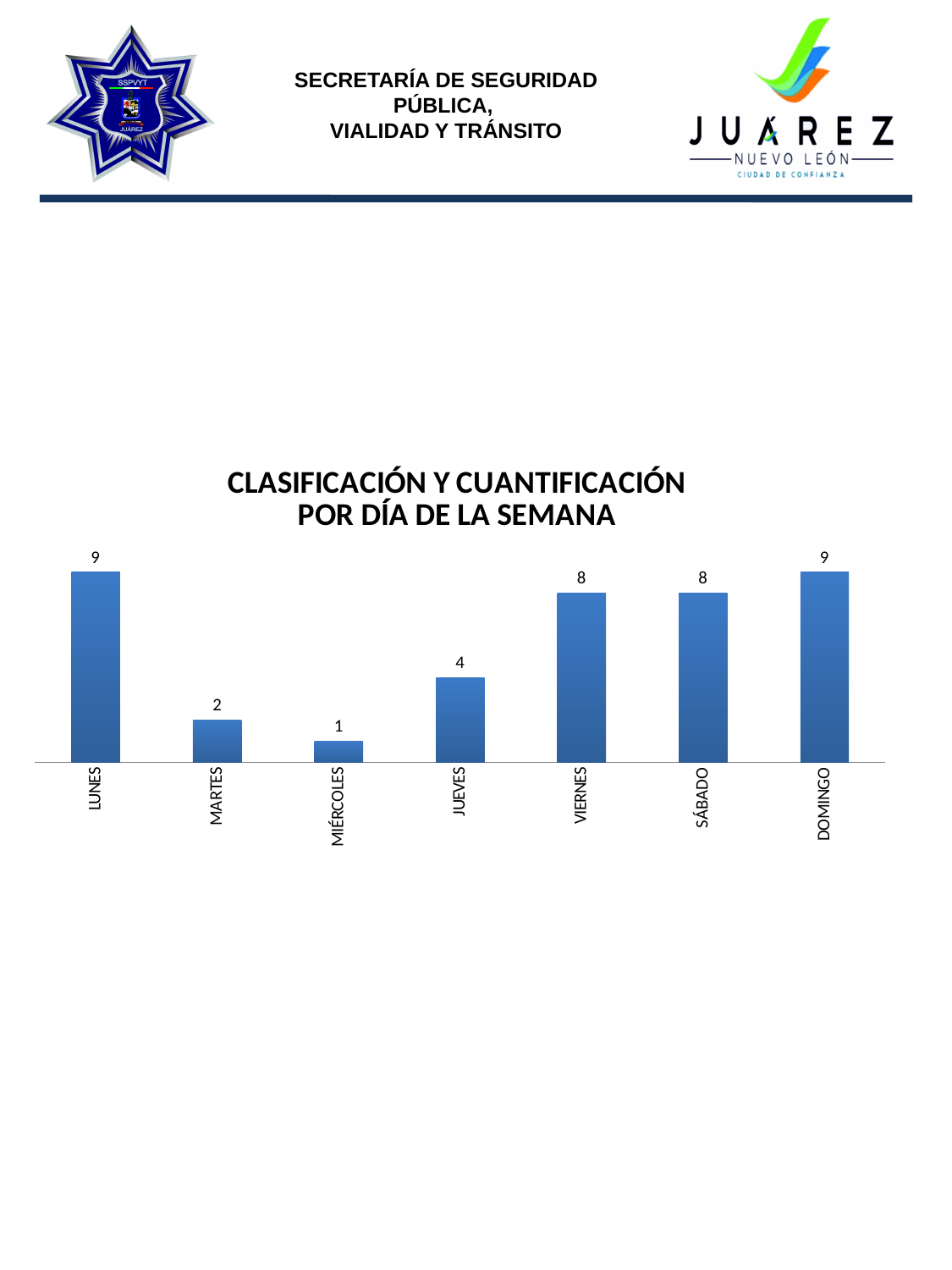
What is the difference between the values for VIERNES and MARTES? 6 Which day has the lowest value? MIÉRCOLES Which is larger, the value for MIÉRCOLES or the value for SÁBADO? SÁBADO What is the title of the chart? CLASIFICACIÓN Y CUANTIFICACIÓN POR DÍA DE LA SEMANA Which is larger, the value for JUEVES or the value for MARTES? JUEVES How many days are shown on the x axis? 7 What kind of chart is shown? Bar chart What is the value for JUEVES? 4 What is the value for SÁBADO? 8 What is the value for LUNES? 9 What is the difference between the values for DOMINGO and JUEVES? 5 Do the values rise or fall from MIÉRCOLES to VIERNES? Rise